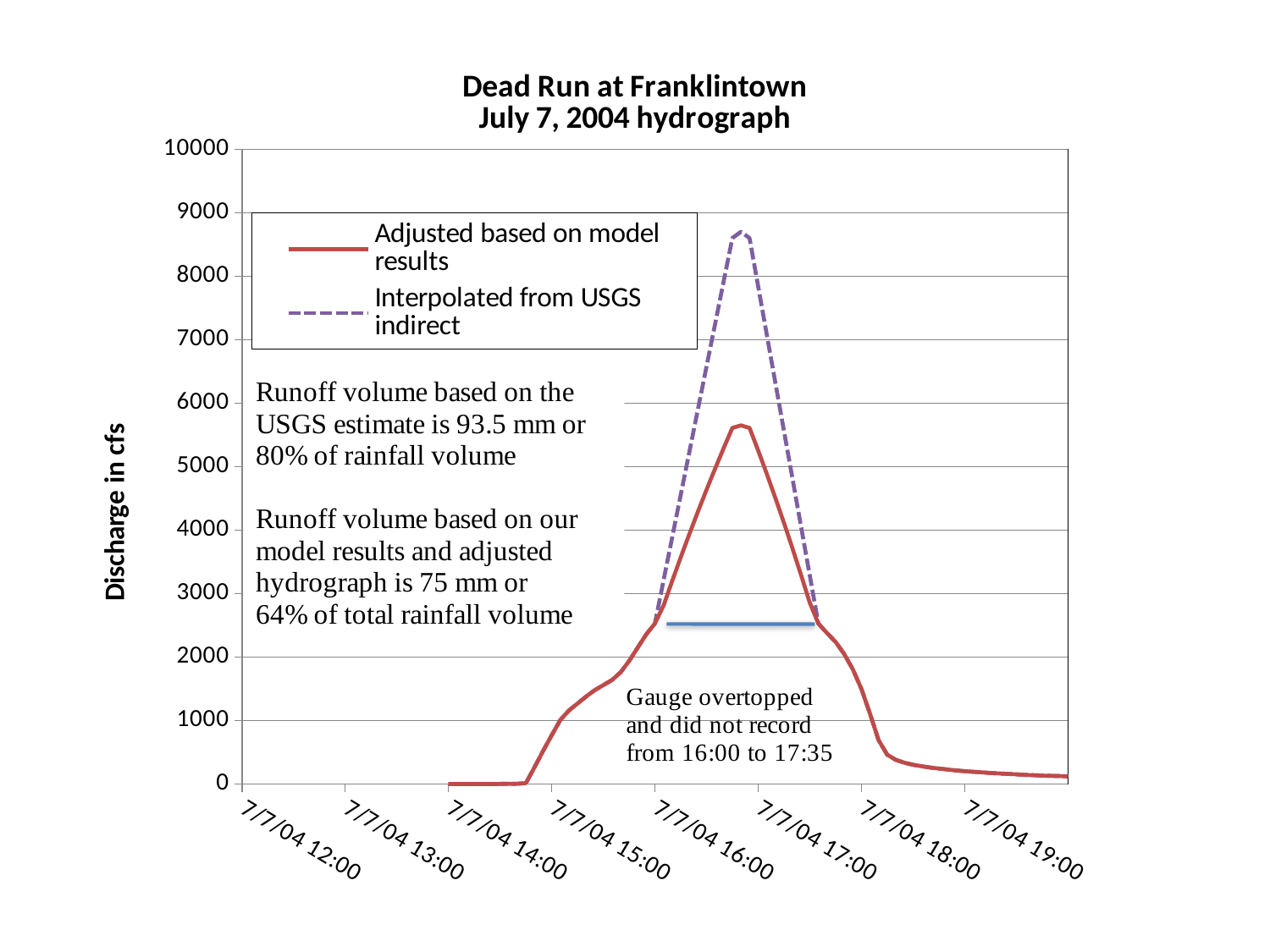
Is the value of the 'Adjusted based on model results' series at 7/7/04 15:00 greater or less than 2000? less What is the title of the chart? Dead Run at Franklintown July 7, 2004 hydrograph What kind of chart is shown on the slide? line chart Is the peak value of the 'Adjusted based on model results' series greater or less than 6000? less Between 7/7/04 14:00 and 7/7/04 16:00, does the 'Adjusted based on model results' series rise or fall? rise Which series reaches the higher peak discharge, 'Adjusted based on model results' or 'Interpolated from USGS indirect'? Interpolated from USGS indirect How many time labels are shown on the horizontal axis? 8 What is the label of the vertical axis? Discharge in cfs How many series does the legend list? 2 Is the value of the 'Adjusted based on model results' series at 7/7/04 18:00 greater or less than 1000? less